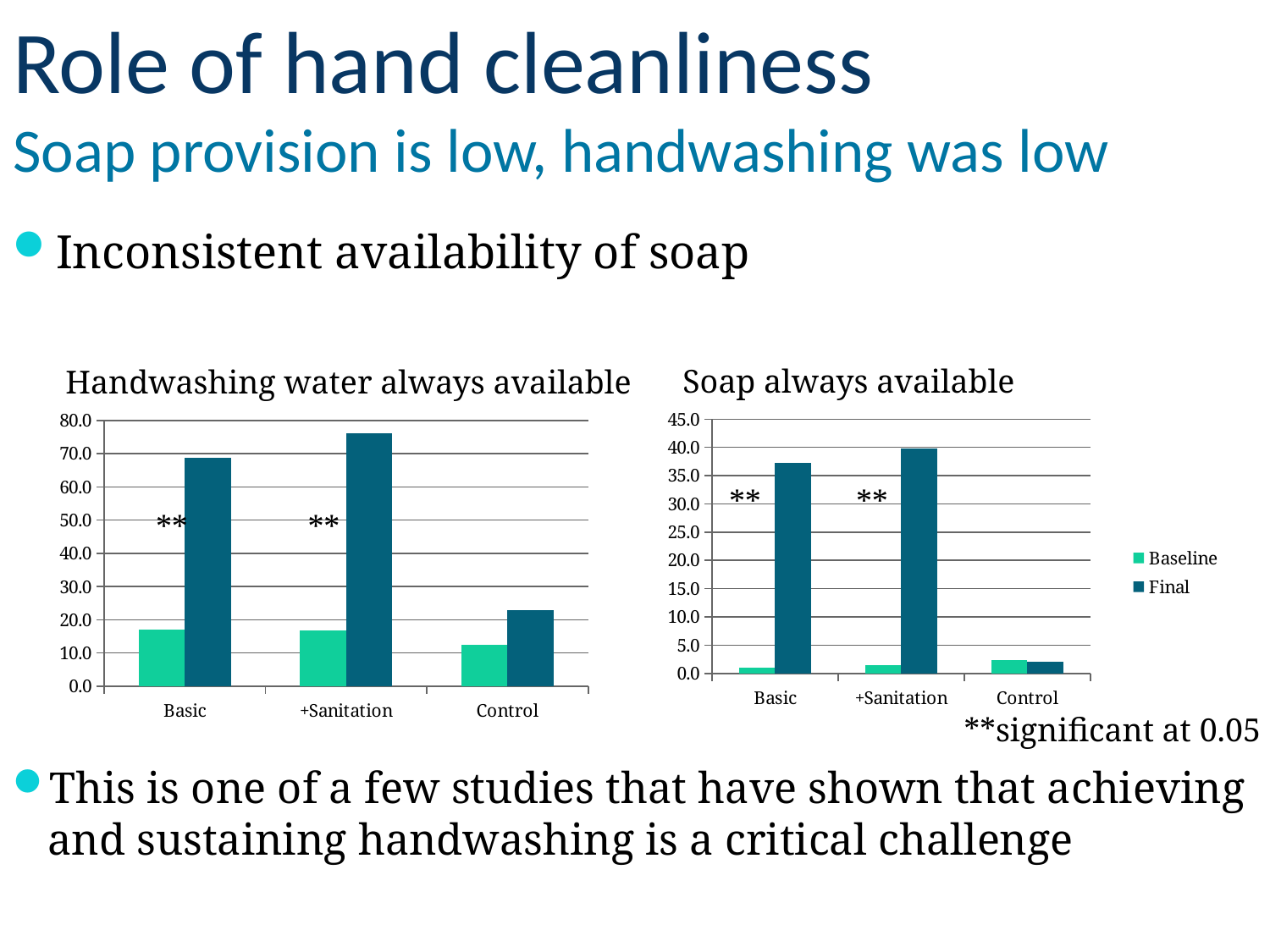
What are the two series named in the legend on the slide? Baseline and Final In the 'Soap always available' chart, which category has the lowest Final value? Control How many categories are shown on the x axis of the 'Soap always available' chart? 3 In the 'Soap always available' chart, is the Final value for +Sanitation greater or less than 35.0? greater In the 'Soap always available' chart, which is larger for Basic: the Baseline value or the Final value? Final In the 'Handwashing water always available' chart, is the Baseline value for Control greater or less than 20.0? less What kind of chart is the 'Handwashing water always available' chart? bar chart In the 'Soap always available' chart, is the Final value for Control greater or less than 5.0? less In the 'Handwashing water always available' chart, which category has the lowest Final value? Control How many series does the legend list for the charts on the slide? 2 In the 'Handwashing water always available' chart, which category has the highest Final value? +Sanitation